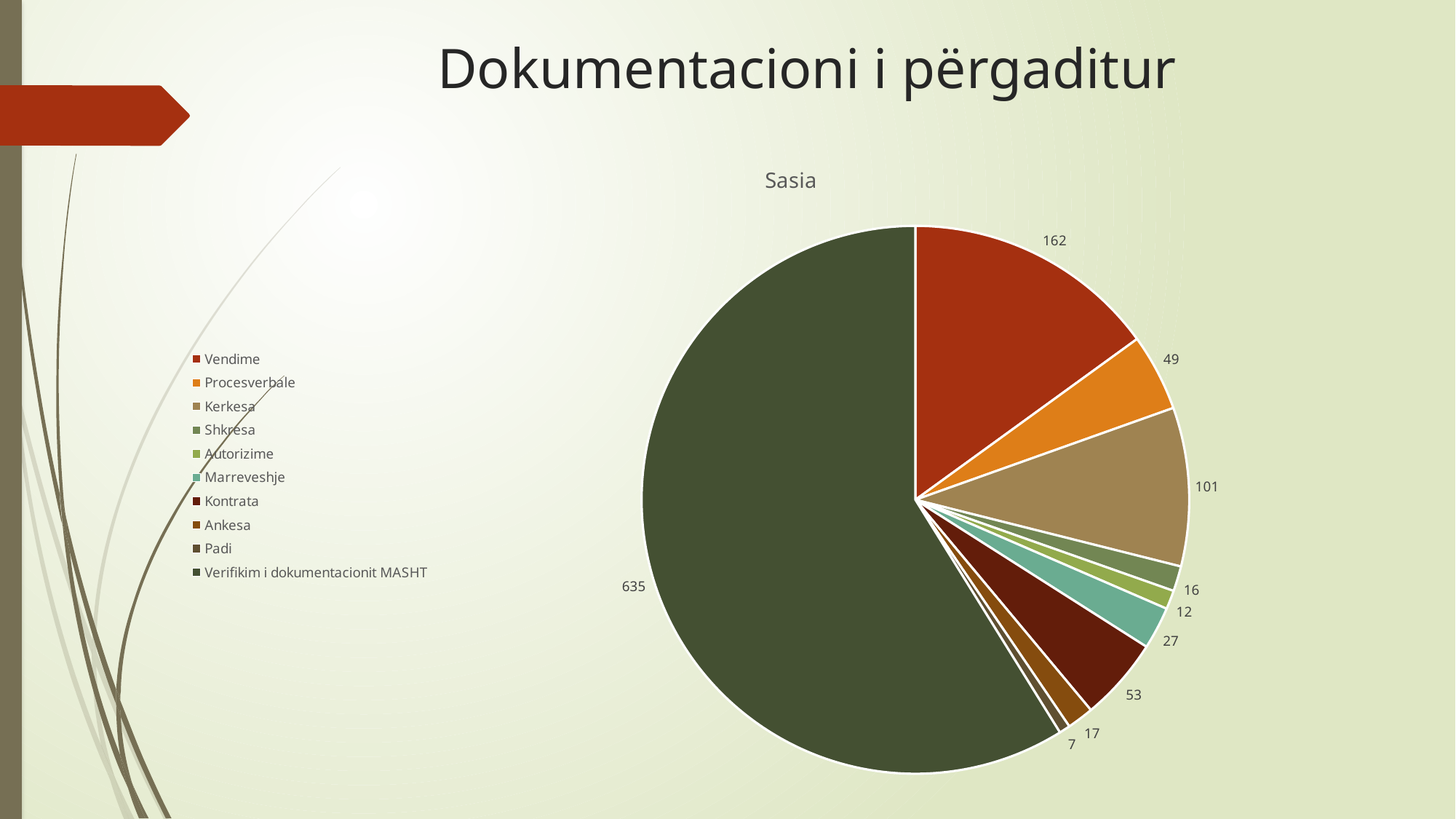
What is the value for Verifikim i dokumentacionit MASHT? 635 Which is larger, the value for Kontrata or the value for Procesverbale? Kontrata What is the value for Padi? 7 Which category has the largest slice? Verifikim i dokumentacionit MASHT What is the total of all the slices in the pie chart? 1079 What is the title of the chart? Sasia What is the value for Vendime? 162 What type of chart is shown on the slide? Pie chart How many categories does the pie chart have? 10 What is the value for Kerkesa? 101 What is the difference between the values for Vendime and Kerkesa? 61 Which category has the smallest slice? Padi